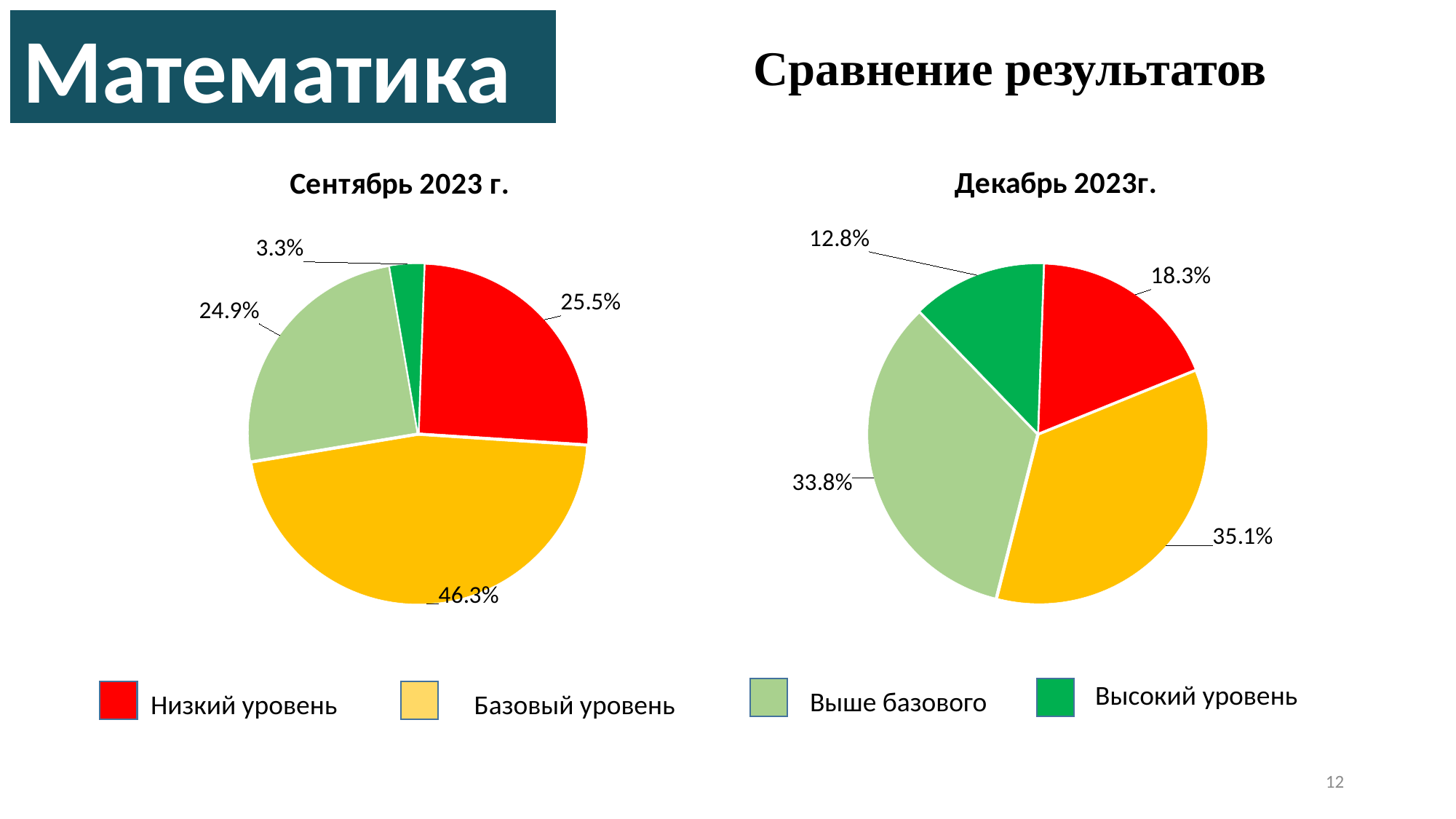
Which colour represents 'Выше базового' in the legend? Light green What is the difference between the 'Высокий уровень' share in the 'Декабрь 2023г.' chart and in the 'Сентябрь 2023 г.' chart? 9.5% How many categories does the legend list? 4 Which is larger: the 'Низкий уровень' share in the 'Сентябрь 2023 г.' chart or in the 'Декабрь 2023г.' chart? Сентябрь 2023 г. How many slices does the 'Декабрь 2023г.' pie chart have? 4 In the 'Декабрь 2023г.' chart, which category has the smallest slice? Высокий уровень What type of chart is used for 'Сентябрь 2023 г.'? Pie chart In the 'Сентябрь 2023 г.' chart, what share is labelled for the 'Высокий уровень' slice? 3.3% In the 'Декабрь 2023г.' chart, what share is labelled for the 'Выше базового' slice? 33.8% In the 'Сентябрь 2023 г.' chart, which category has the largest slice? Базовый уровень In the 'Декабрь 2023г.' chart, what share is labelled for the 'Базовый уровень' slice? 35.1% In the 'Сентябрь 2023 г.' chart, what share is labelled for the 'Низкий уровень' slice? 25.5%